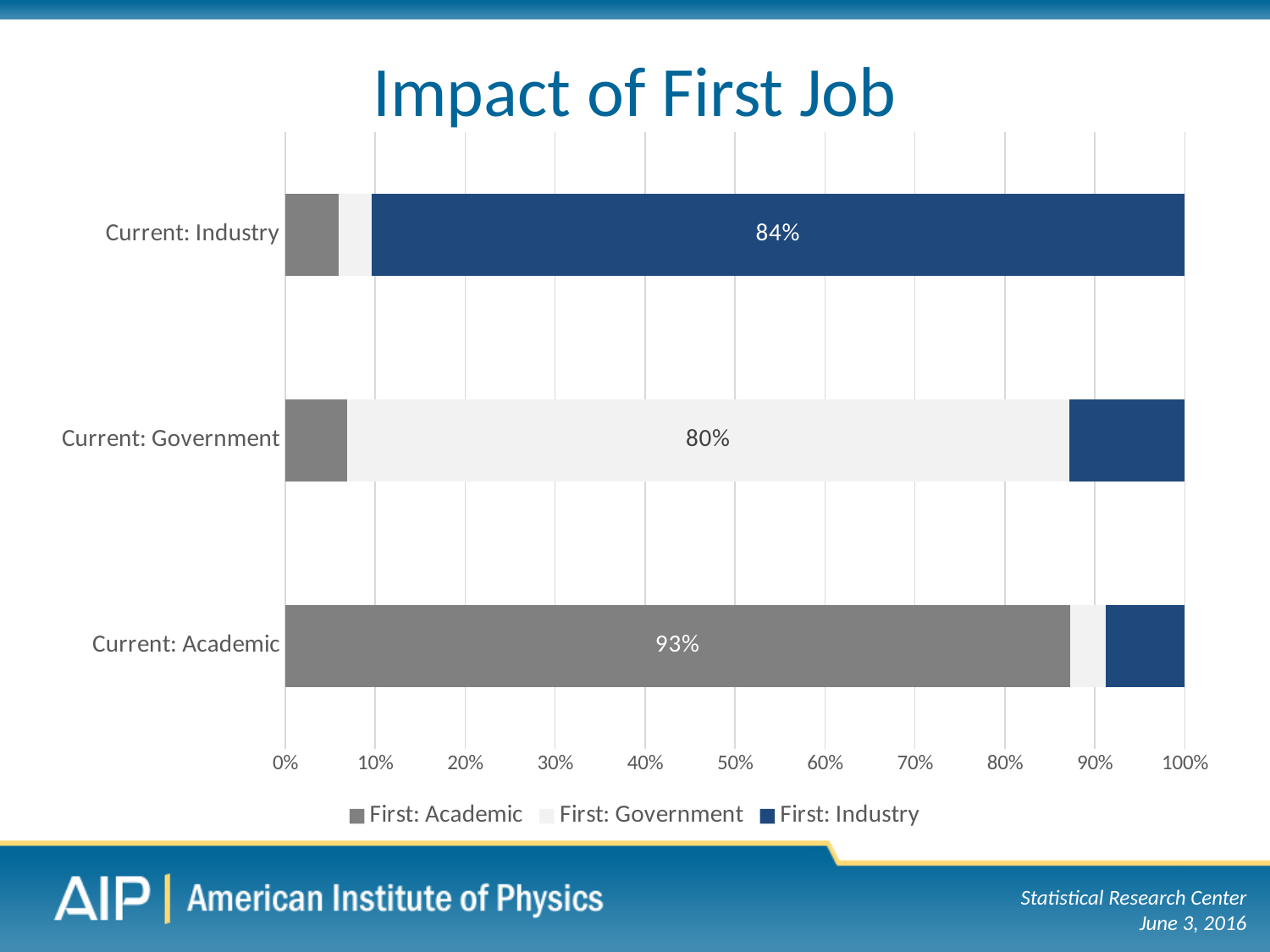
What percentage of those currently in academic positions had their first job in academia? 93% Which current sector has the highest labelled share of people whose first job was in the same sector? Current: Academic Which is larger: the labelled value for Current: Industry or for Current: Government? Current: Industry What type of chart is shown on the slide? Stacked bar chart What is the difference between the labelled value for Current: Academic (93%) and Current: Industry (84%)? 9 percentage points What percentage of those currently in industry had their first job in industry? 84% What percentage of those currently in government had their first job in government? 80% How many series does the legend list? 3 Which current sector has the lowest labelled share of people whose first job was in the same sector? Current: Government Is the First: Academic share for Current: Industry greater or less than 10%? less Is the First: Industry share for Current: Government greater or less than 10%? greater How many current-sector categories are shown on the chart? 3